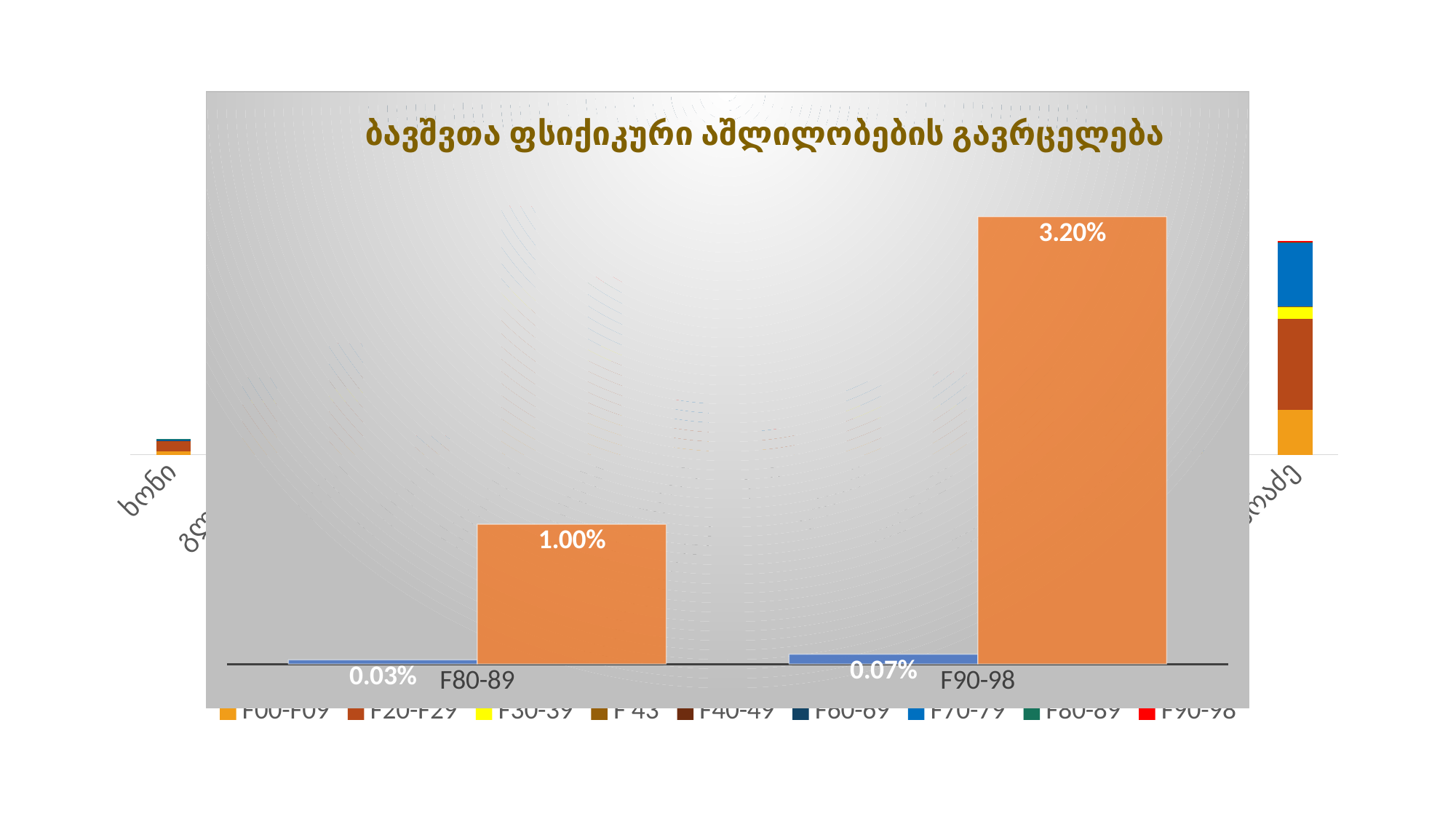
What is the difference between the orange bar values for F90-98 and F80-89? 2.20% What is the value of the orange bar for F90-98? 3.20% What is the value of the orange bar for F80-89? 1.00% Which category has the lowest blue bar? F80-89 What is the value of the blue bar for F90-98? 0.07% Which is larger: the orange bar for F80-89 or the blue bar for F90-98? The orange bar for F80-89 What is the difference between the blue bar values for F90-98 and F80-89? 0.04% Do the orange bar values rise or fall from F80-89 to F90-98? Rise How many categories are shown on the x axis of the main chart? 2 Which category has the highest orange bar? F90-98 What is the value of the blue bar for F80-89? 0.03% What type of chart is the main chart on the slide? Bar chart